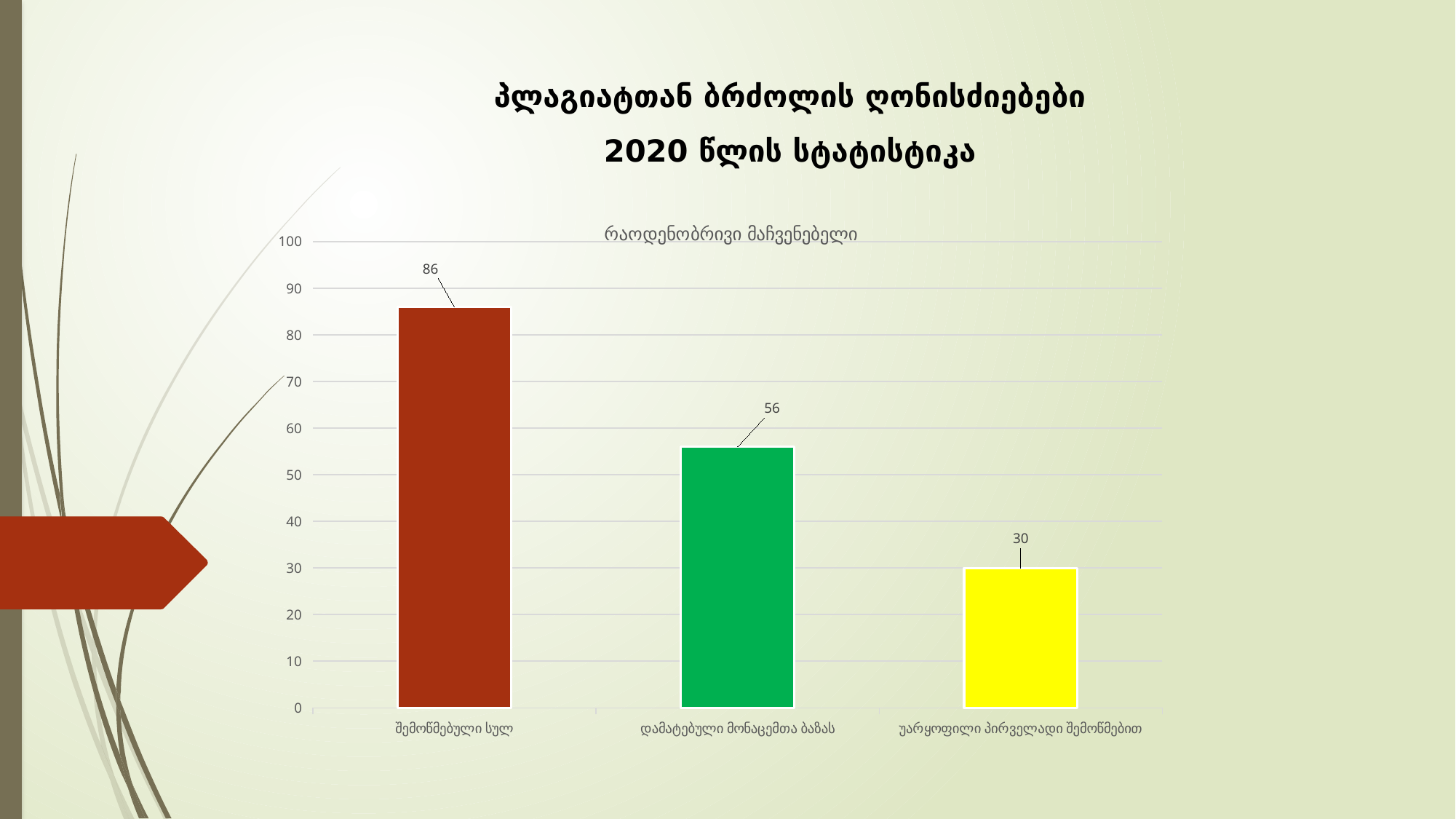
How many categories are shown on the chart? 3 Which is larger, the value for დამატებული მონაცემთა ბაზას or the value for უარყოფილი პირველადი შემოწმებით? დამატებული მონაცემთა ბაზას What is the value for დამატებული მონაცემთა ბაზას? 56 Is the value for შემოწმებული სულ greater or less than 80? greater Which category has the highest value? შემოწმებული სულ What is the difference between the values for შემოწმებული სულ and დამატებული მონაცემთა ბაზას? 30 What is the title of the chart? რაოდენობრივი მაჩვენებელი Which category has the lowest value? უარყოფილი პირველადი შემოწმებით What is the value for შემოწმებული სულ? 86 What kind of chart is shown on the slide? bar chart What is the difference between the values for დამატებული მონაცემთა ბაზას and უარყოფილი პირველადი შემოწმებით? 26 What is the value for უარყოფილი პირველადი შემოწმებით? 30